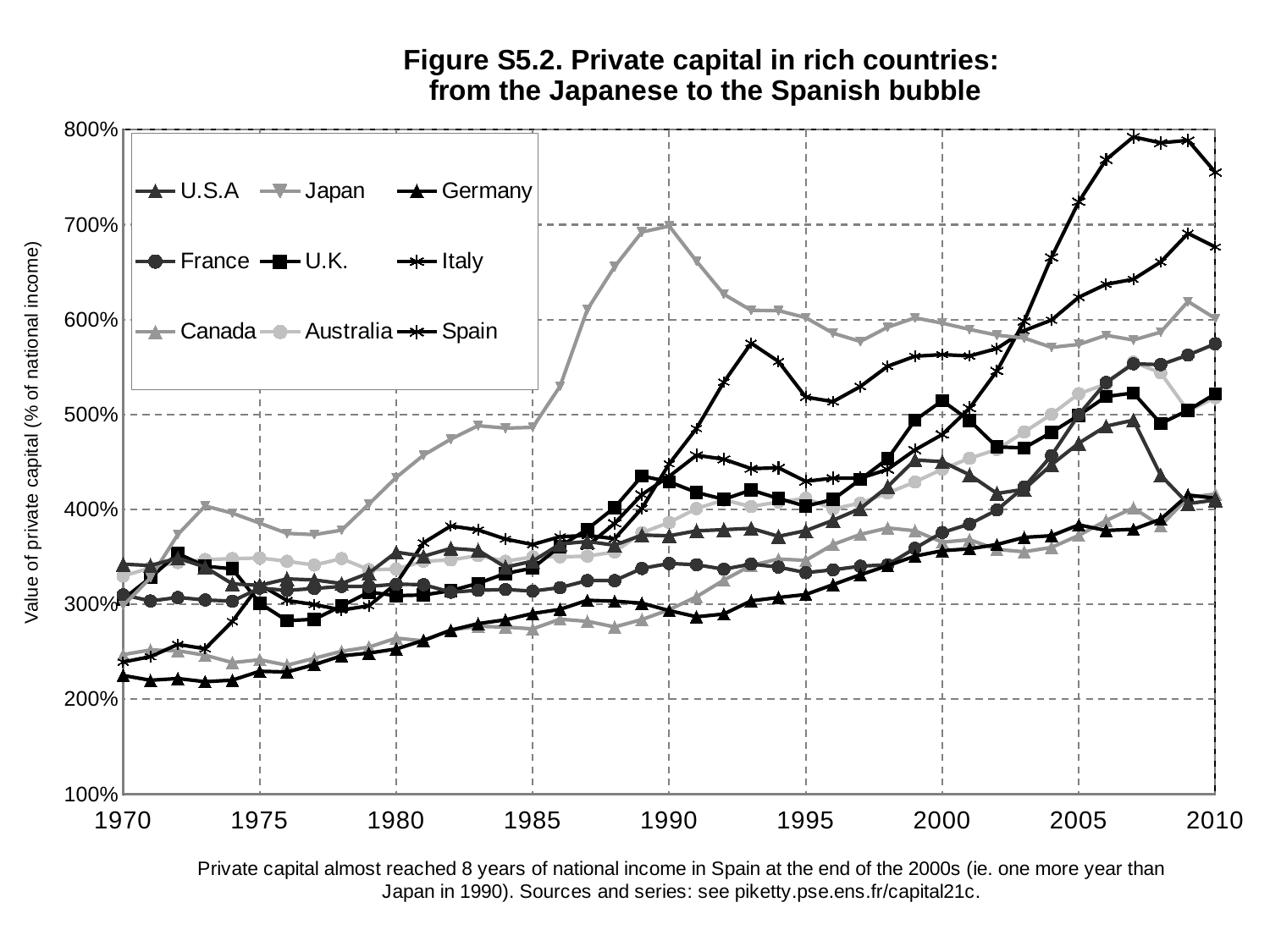
Does the value for Japan rise or fall between 1990 and 1995? fall Is the value for Italy in 1993 greater or less than 500%? greater In 2000, which is higher: the value for the U.K. or the value for France? U.K. What kind of chart is shown on the slide? line chart Is the value for Spain in 2007 greater or less than 700%? greater Which country has the lowest value of private capital in 1970? Germany Which country has the highest value of private capital in 1990? Japan Which country has the highest value of private capital in 2010? Spain What is the title of the chart? Figure S5.2. Private capital in rich countries: from the Japanese to the Spanish bubble Is the value for Germany in 1970 greater or less than 300%? less What is the label of the vertical axis? Value of private capital (% of national income) How many series does the legend list? 9